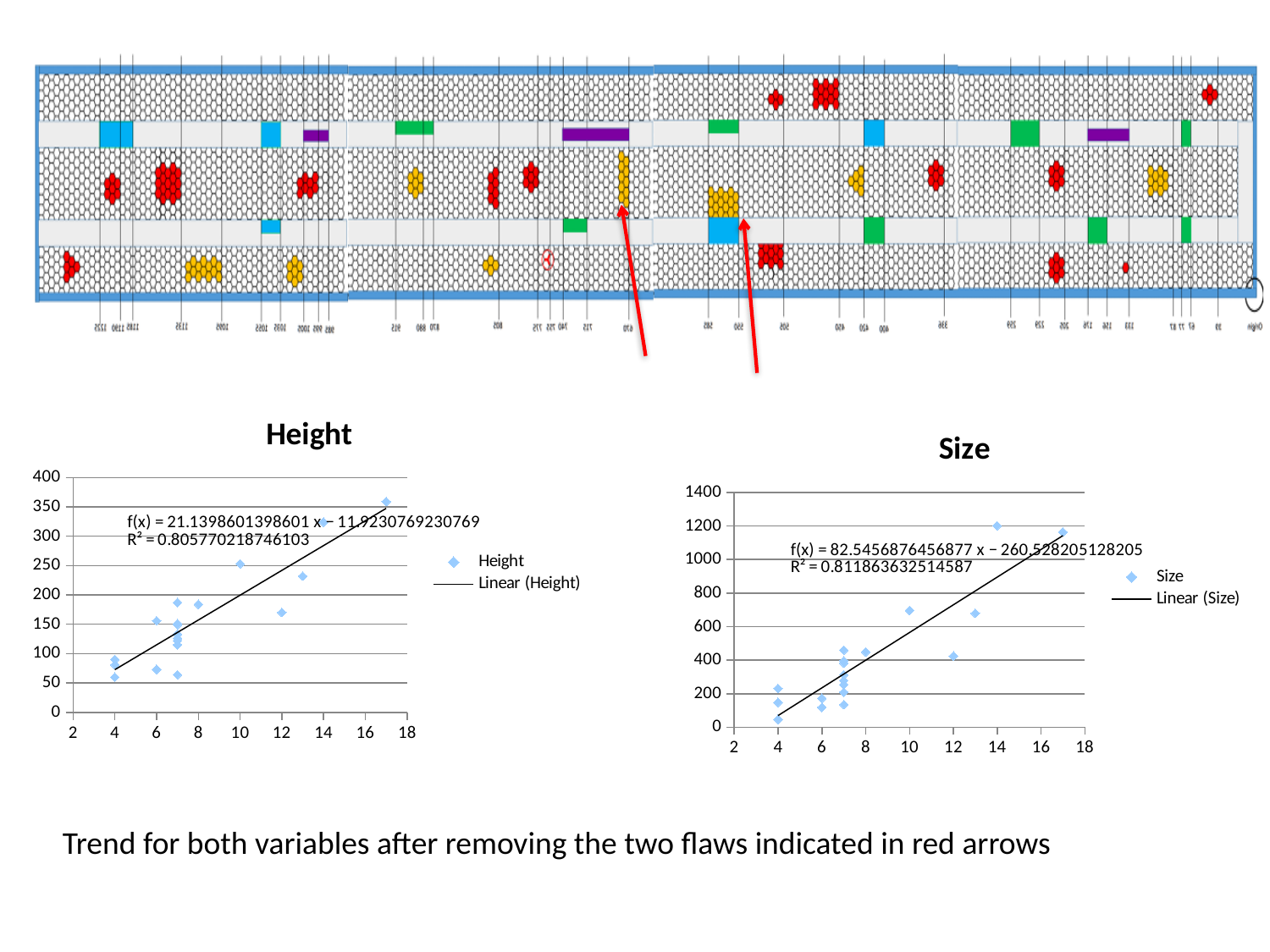
What R² value is printed on the "Height" chart? R² = 0.805770218746103 In the "Height" chart, do the values generally rise or fall as the x-axis value increases? rise What kind of chart is the chart titled "Size"? scatter chart In the "Height" chart, how many entries does the legend list? 2 In the "Height" chart, is the value of the point at x = 10 greater or less than 200? greater In the "Size" chart, is the value of the point at x = 17 greater or less than 1000? greater What is the name of the trendline entry in the legend of the "Size" chart? Linear (Size) In the "Size" chart, how many entries does the legend list? 2 What kind of chart is the chart titled "Height"? scatter chart In the "Height" chart, is the lowest point at x = 4 greater or less than 100? less In the "Size" chart, do the values generally rise or fall as the x-axis value increases? rise